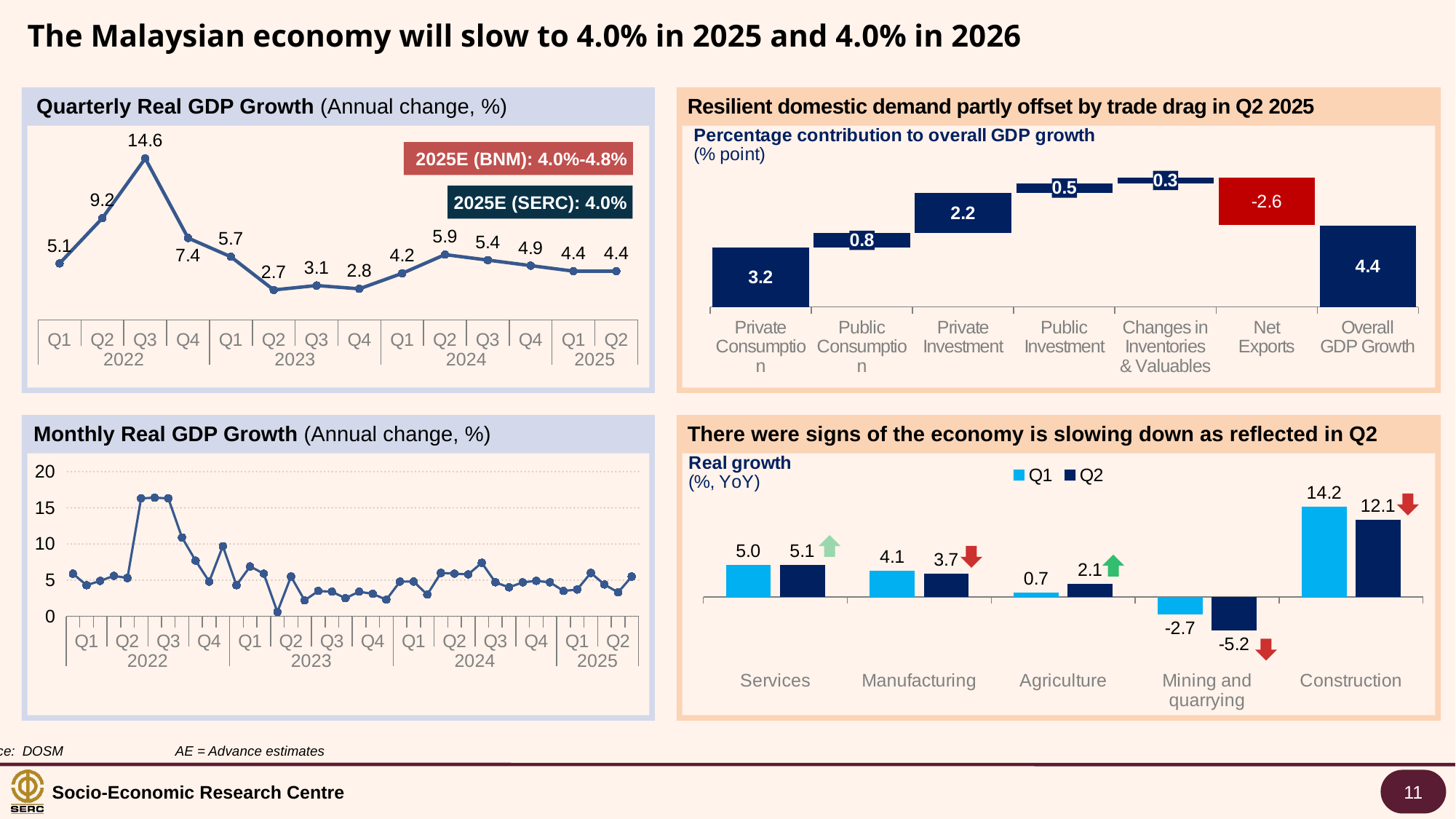
In the Real growth by sector chart (bottom right), what is the Q2 value for Mining and quarrying? -5.2 In the Percentage contribution to overall GDP growth chart, which component has the largest positive contribution? Private Consumption In the Percentage contribution to overall GDP growth chart, what is the contribution of Net Exports? -2.6 How many quarterly data points are plotted in the Quarterly Real GDP Growth chart? 14 In the Percentage contribution to overall GDP growth chart, is the contribution of Private Investment larger than that of Public Consumption? Yes In the Real growth by sector chart (bottom right), what is the difference between the Q1 and Q2 values for Construction? 2.1 What type of chart is the Monthly Real GDP Growth chart? Line chart In the Quarterly Real GDP Growth chart, which quarter had the lowest growth? Q2 2023 How many series does the legend list in the Real growth by sector chart (bottom right)? 2 In the Quarterly Real GDP Growth chart, what is the difference between Q2 2024 and Q2 2025? 1.5 In the Quarterly Real GDP Growth chart, what was the value for Q3 2022? 14.6 In the Real growth by sector chart (bottom right), which sector has the highest Q1 growth? Construction